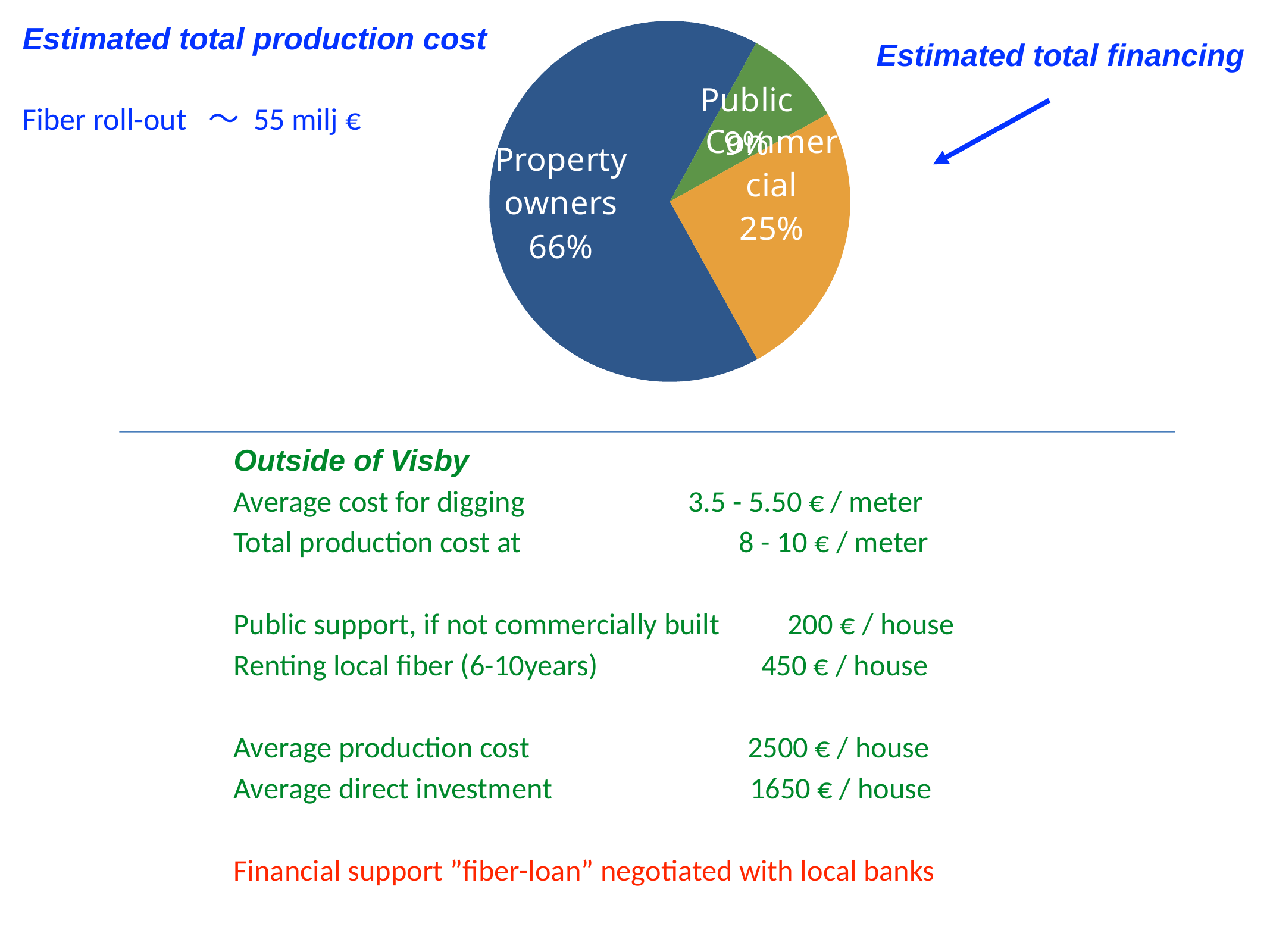
What is the title associated with the pie chart, indicated by the blue arrow? Estimated total financing By how many percentage points does the Commercial share exceed the Public share? 16 percentage points What share of the estimated total financing comes from property owners? 66% What kind of chart is shown on the slide? pie chart By how many percentage points does the Property owners share exceed the Commercial share? 41 percentage points Which slice of the pie chart is the smallest? Public What share of the estimated total financing is commercial? 25% How many slices does the pie chart have? 3 What share of the estimated total financing is public? 9% Which is larger in the pie chart, the Commercial slice or the Public slice? Commercial What colour is the Property owners slice of the pie chart? blue Which slice of the pie chart is the largest? Property owners